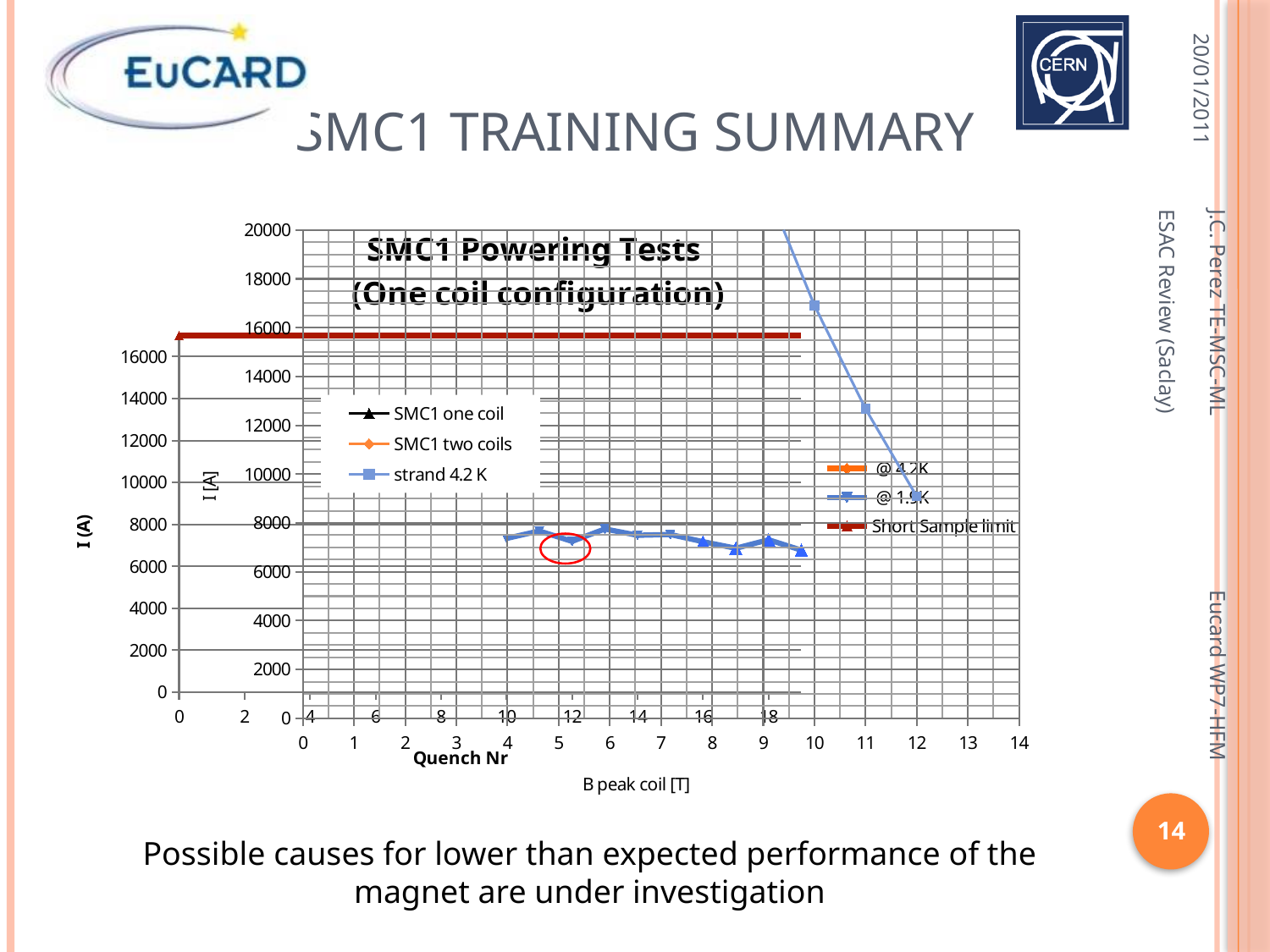
In the SMC1 Powering Tests chart, are the SMC1 quench current points greater or less than 10000 A? less How many series does the legend box containing 'SMC1 one coil' list in the SMC1 Powering Tests chart? 3 What is the label of the horizontal axis of the background chart behind the SMC1 Powering Tests chart? B peak coil [T] What kind of chart is the SMC1 Powering Tests chart? line chart In the SMC1 Powering Tests chart, which is larger: the Short Sample limit or the SMC1 quench currents? Short Sample limit In the SMC1 Powering Tests chart, are the SMC1 quench current points greater or less than 6000 A? greater In the SMC1 Powering Tests chart, does the strand 4.2 K curve rise or fall as B peak coil increases? fall In the SMC1 Powering Tests chart, is the strand 4.2 K value at 11 T greater or less than 12000 A? greater What is the label of the horizontal axis of the SMC1 Powering Tests chart? Quench Nr What is the title of the chart in the foreground? SMC1 Powering Tests (One coil configuration)